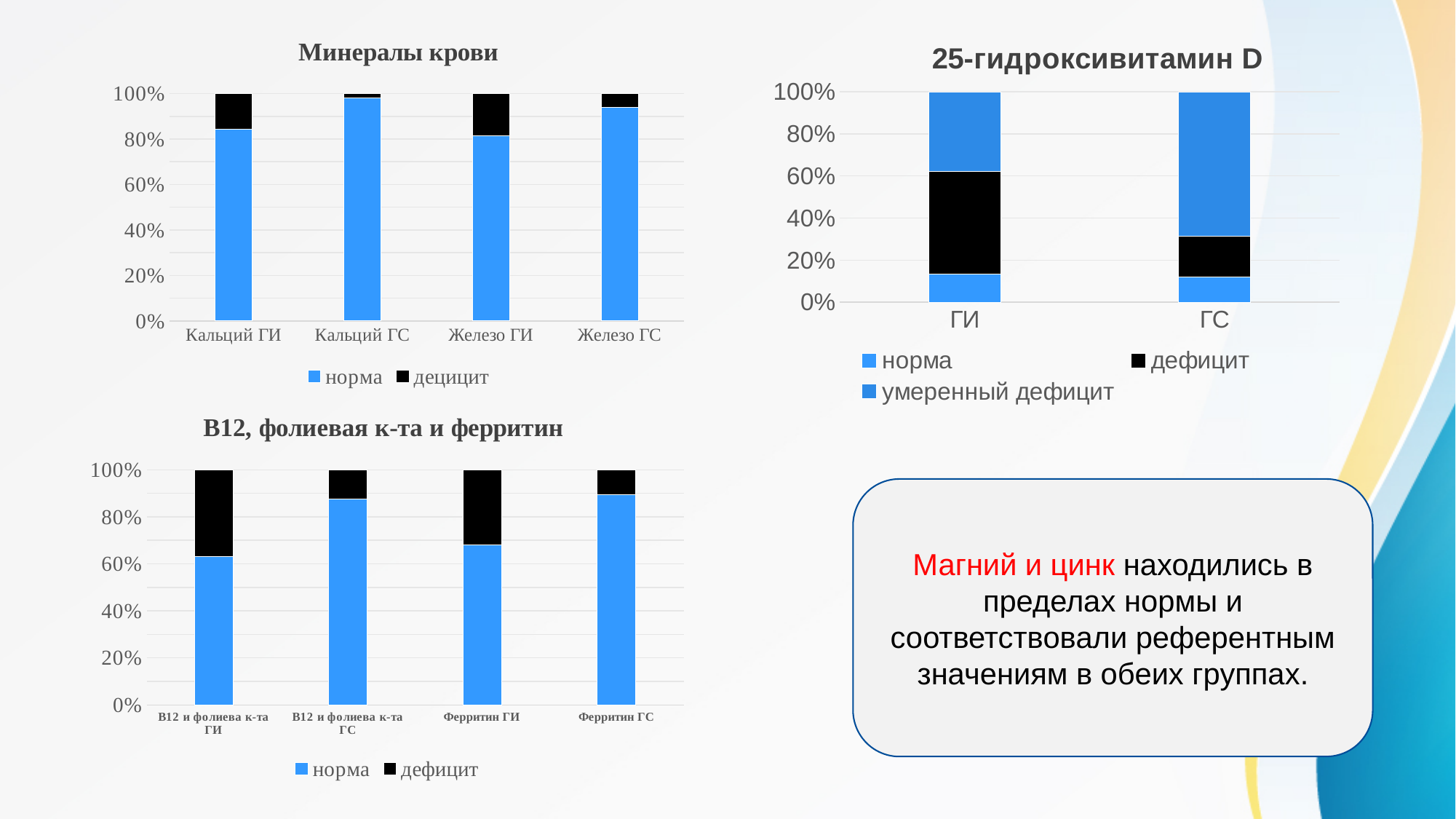
How many categories are shown on the x axis of the "Минералы крови" chart? 4 What type of chart is "Минералы крови"? stacked bar chart In the "B12, фолиевая к-та и ферритин" chart, which category has the lowest share of норма? B12 и фолиева к-та ГИ In the "25-гидроксивитамин D" chart, is the норма share for ГИ greater or less than 20%? less In the "25-гидроксивитамин D" chart, which group has the larger дефицит segment, ГИ or ГС? ГИ What colour represents норма in the "B12, фолиевая к-та и ферритин" chart? blue In the "B12, фолиевая к-та и ферритин" chart, is the норма share for Ферритин ГИ greater or less than 80%? less In the "Минералы крови" chart, which category has the highest share of норма? Кальций ГС How many series does the legend of the "Минералы крови" chart list? 2 In the "Минералы крови" chart, is the норма share for Кальций ГС greater or less than 90%? greater How many series does the legend of the "25-гидроксивитамин D" chart list? 3 How many categories are shown on the x axis of the "25-гидроксивитамин D" chart? 2